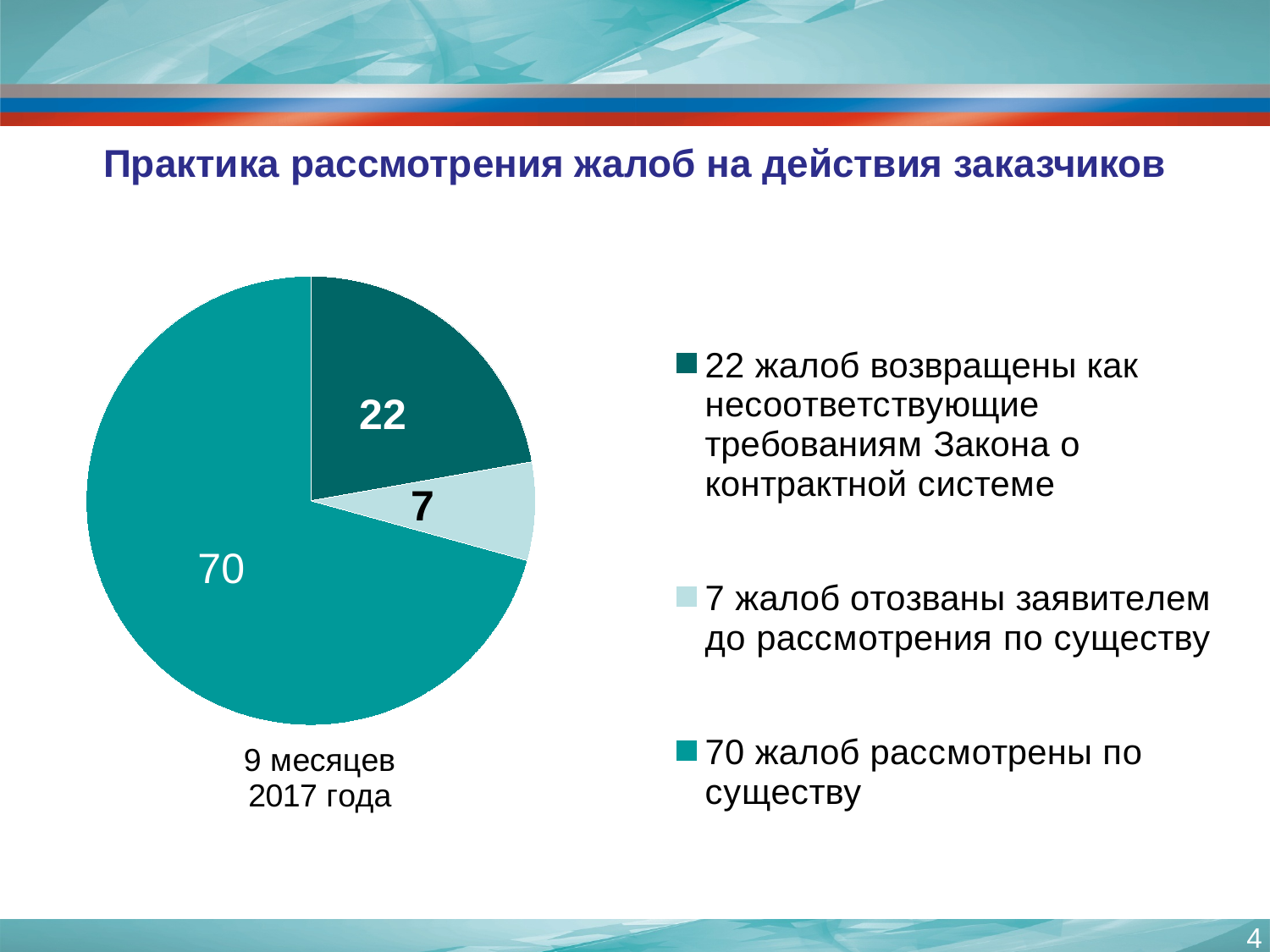
Which is larger: the number of complaints returned as non-compliant or the number withdrawn by the applicant? returned as non-compliant (22) Which category has the smallest slice of the pie? 7 жалоб отозваны заявителем до рассмотрения по существу Which category has the largest slice of the pie? 70 жалоб рассмотрены по существу How many complaints were considered on the merits (рассмотрены по существу)? 70 What period does the caption under the pie chart refer to? 9 месяцев 2017 года What is the difference between the number of complaints considered on the merits and the number returned as non-compliant? 48 How many complaints were returned as not meeting the requirements of the Law on the contract system (возвращены как несоответствующие требованиям Закона о контрактной системе)? 22 How many entries does the legend list? 3 How many complaints were withdrawn by the applicant before consideration on the merits (отозваны заявителем до рассмотрения по существу)? 7 What kind of chart is shown on the slide? pie chart How many slices does the pie chart have? 3 What is the total number of complaints across all three slices of the pie? 99